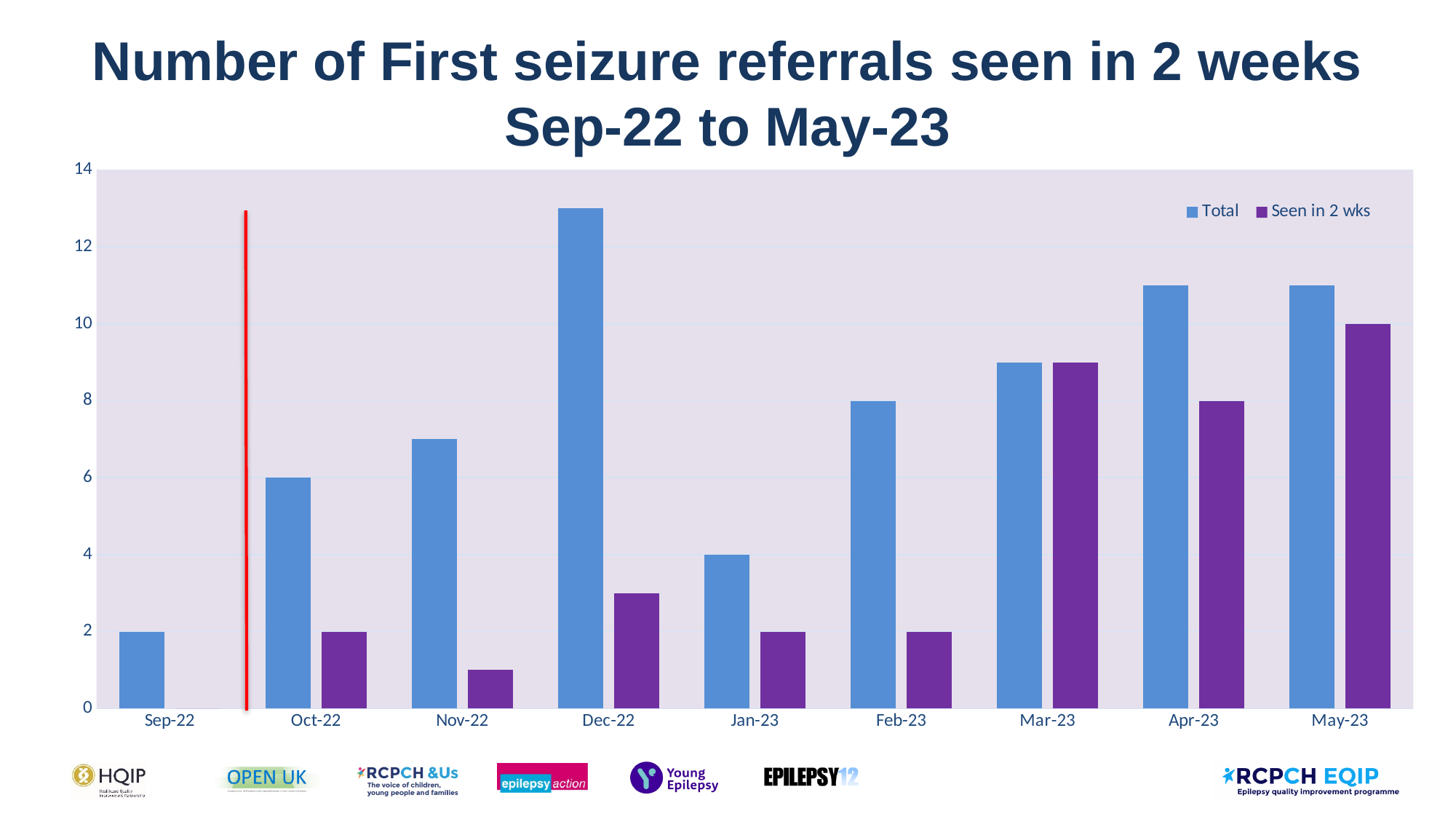
Which month has the lowest Total value? Sep-22 Is the Seen in 2 wks value for Nov-22 greater or less than 2? less Which month has the highest Total value? Dec-22 What is the Total value for Oct-22? 6 What is the Seen in 2 wks value for May-23? 10 How many months are shown on the x axis? 9 Which is larger, the Total value for Dec-22 or the Total value for Mar-23? Dec-22 How many series does the legend list? 2 What is the Total value for Feb-23? 8 Is the Total value for Dec-22 greater or less than 12? greater What type of chart is shown on the slide? bar chart What is the difference between the Total and Seen in 2 wks values for Feb-23? 6